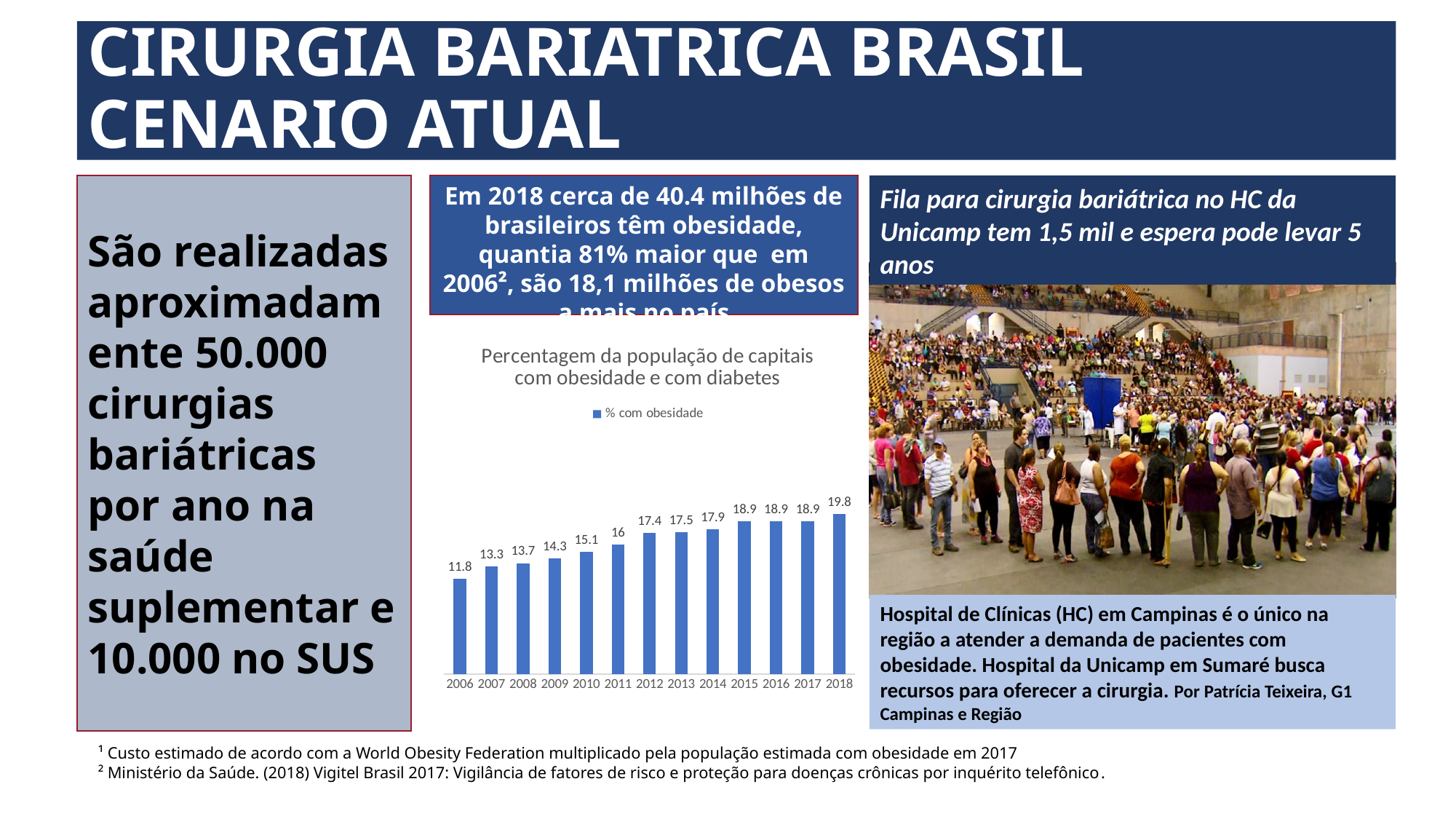
What is the value for 2006 in the chart? 11.8 How many series does the chart legend list? 1 How many years are shown on the x axis of the chart? 13 What kind of chart is shown on the slide? bar chart Which year has the highest value in the chart? 2018 What is the difference between the values for 2018 and 2006? 8 What is the value for 2018 in the chart? 19.8 Do the values in the chart generally rise or fall from 2006 to 2018? rise Which year has the lowest value in the chart? 2006 Which is larger, the value for 2012 or the value for 2010? 2012 What is the legend entry of the chart? % com obesidade What is the value for 2011 in the chart? 16